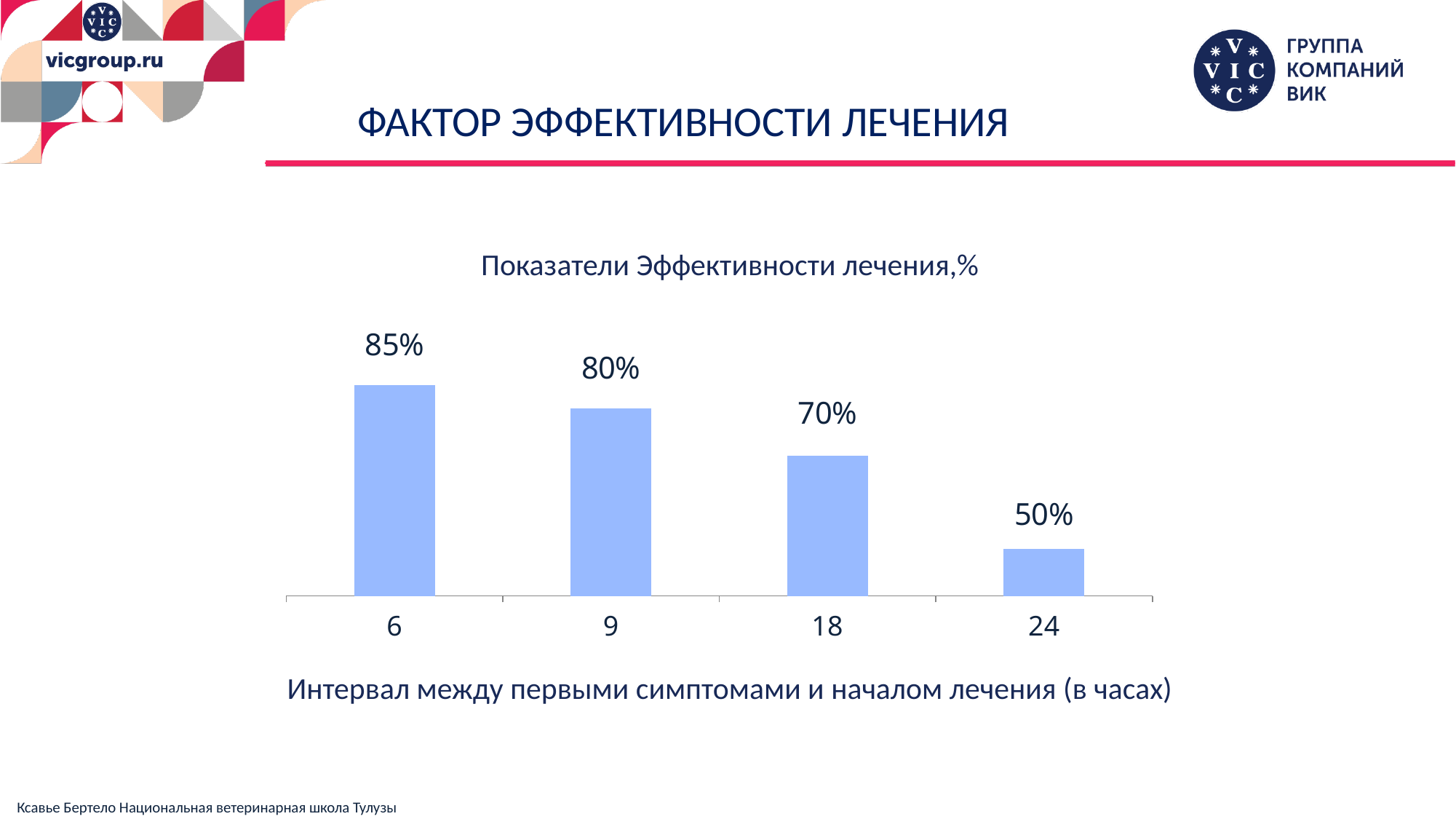
What is the difference between the effectiveness at 6 hours and at 24 hours? 35% What kind of chart is shown on the slide? Bar chart Which is larger: the effectiveness at 9 hours or at 18 hours? 9 hours Which interval has the highest treatment effectiveness? 6 How many intervals (bars) are shown in the chart? 4 Do the effectiveness values rise or fall as the interval increases along the x axis? Fall What is the treatment effectiveness value for an interval of 18 hours? 70% What is the treatment effectiveness value for an interval of 6 hours? 85% What is the treatment effectiveness value for an interval of 24 hours? 50% Which interval has the lowest treatment effectiveness? 24 What is the difference between the effectiveness at 9 hours and at 18 hours? 10% What is the treatment effectiveness value for an interval of 9 hours? 80%